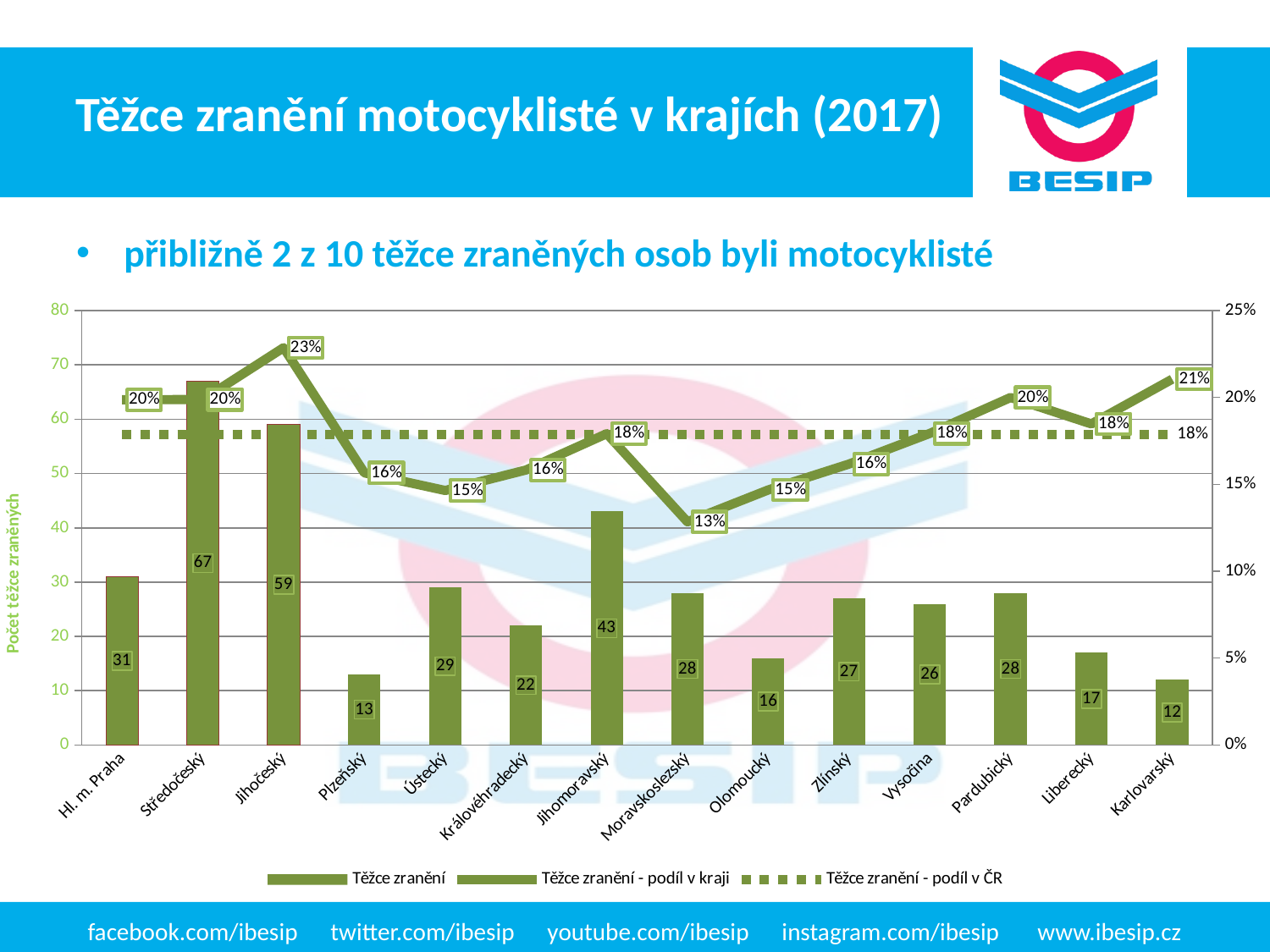
Which region has the highest number of Těžce zranění? Středočeský How many seriously injured motorcyclists (Těžce zranění) are shown for Středočeský? 67 Which has a higher Těžce zranění value, Hl. m. Praha or Zlínský? Hl. m. Praha What is the title of the chart slide? Těžce zranění motocyklisté v krajích (2017) What is the 'Těžce zranění - podíl v kraji' value for Jihočeský? 23% What is the difference between the Těžce zranění values for Středočeský and Jihočeský? 8 Which region has the lowest number of Těžce zranění? Karlovarský What is the Těžce zranění value for Jihomoravský? 43 Which region has the lowest 'Těžce zranění - podíl v kraji' value? Moravskoslezský How many regions are shown on the x axis? 14 What value does the dotted 'Těžce zranění - podíl v ČR' line show? 18% How many series does the legend list? 3